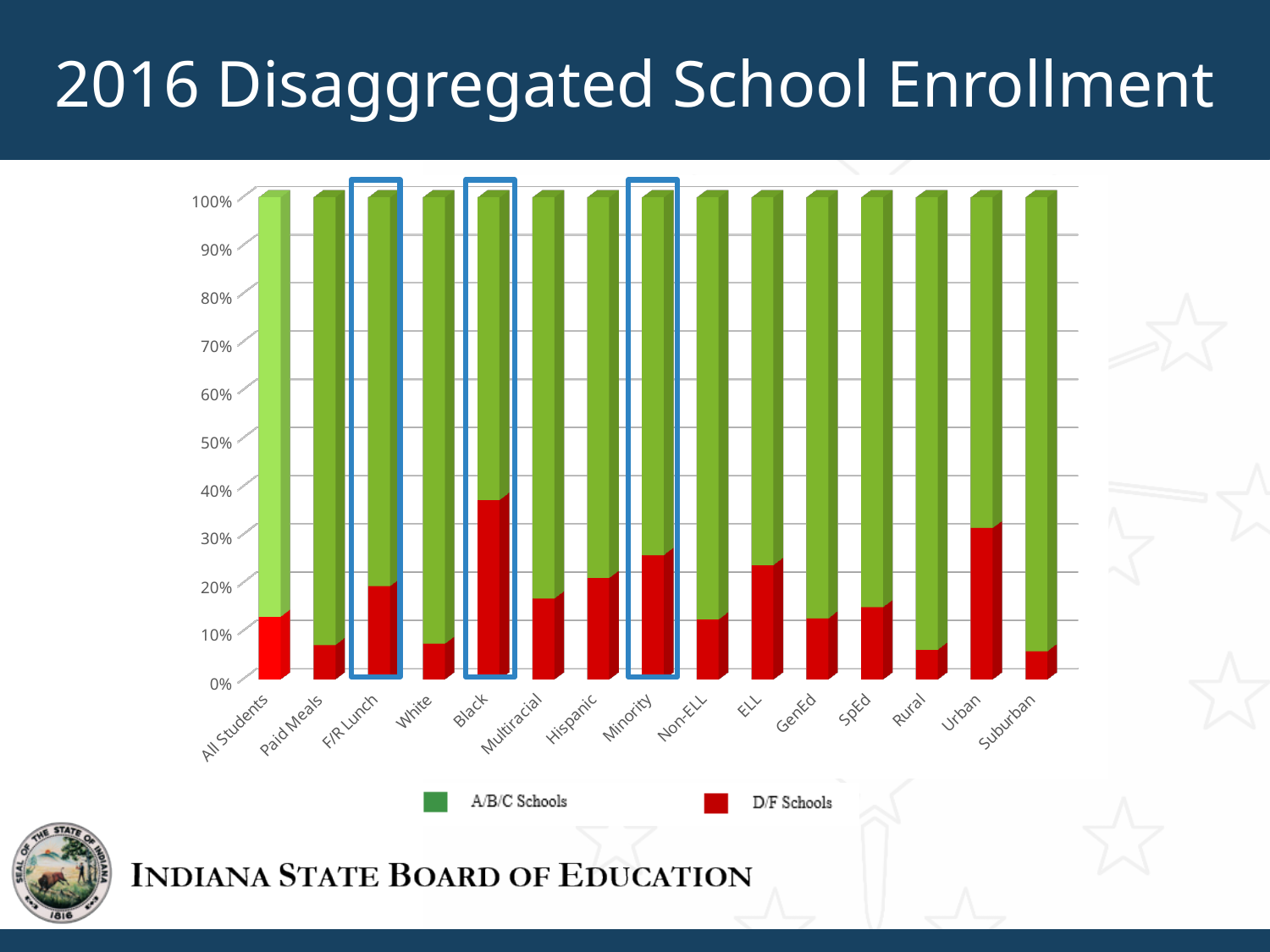
What kind of chart is shown on the slide? stacked bar chart Which three categories are outlined with blue boxes on the chart? F/R Lunch, Black, Minority Is the D/F Schools share for Black greater or less than 30%? greater What are the two series named in the legend? A/B/C Schools and D/F Schools Is the D/F Schools share for F/R Lunch greater or less than 10%? greater Which category has the largest D/F Schools share? Black How many categories are shown along the x axis? 15 How many series does the legend list? 2 Which has a larger D/F Schools share, Urban or Suburban? Urban Which has a larger D/F Schools share, ELL or Non-ELL? ELL Is the D/F Schools share for Paid Meals greater or less than 10%? less